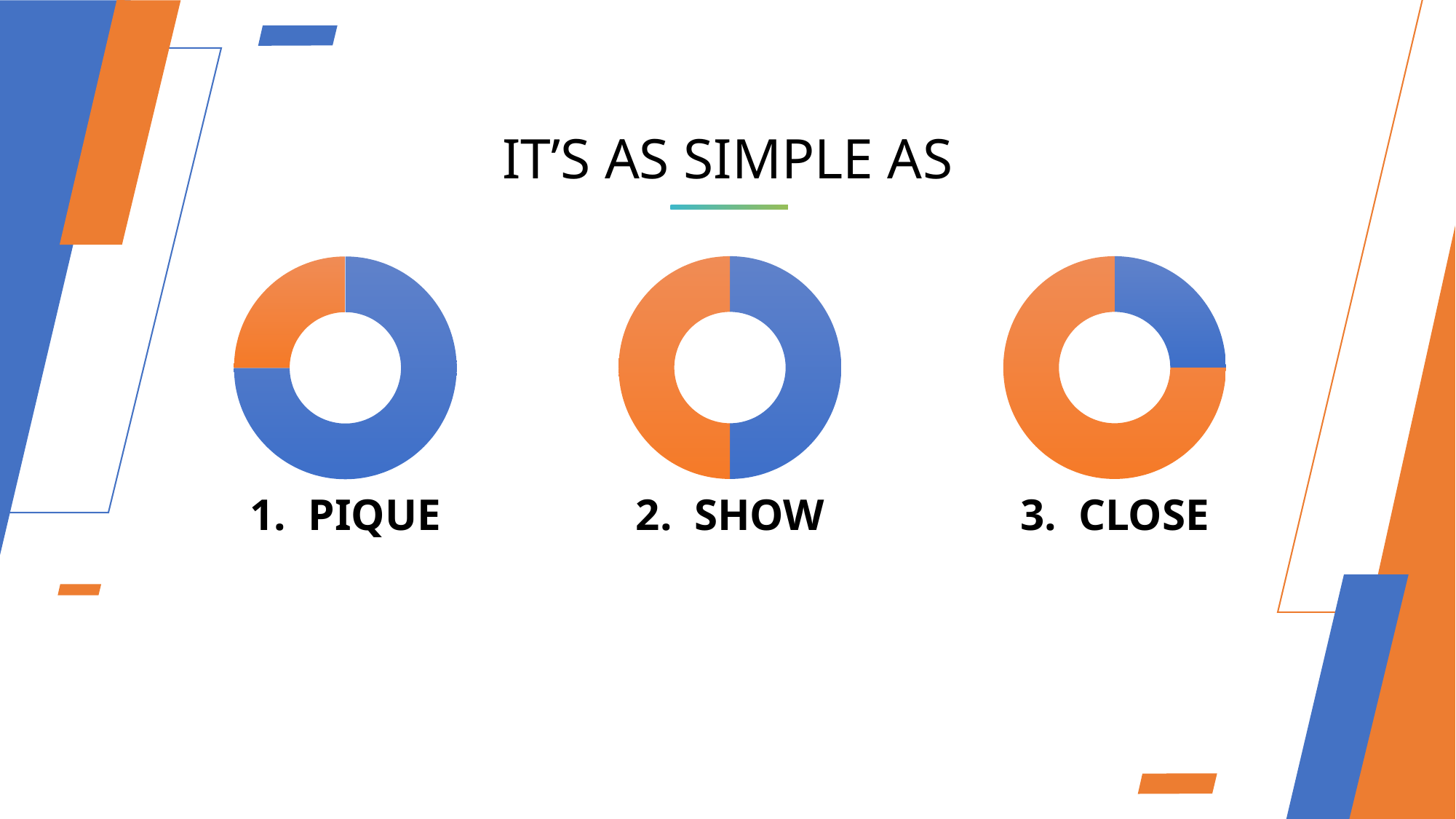
In the "3. CLOSE" chart, which slice is larger, the blue one or the orange one? orange Which of the three charts has the largest blue slice? 1. PIQUE In the "3. CLOSE" chart, how many slices are there? 2 In the "1. PIQUE" chart, how many slices are there? 2 Which of the three charts has the largest orange slice? 3. CLOSE What is the label under the middle chart? 2. SHOW What kind of chart is shown under the label "1. PIQUE"? doughnut chart How many charts are on the slide? 3 What is the title of the slide above the three charts? IT'S AS SIMPLE AS In the "1. PIQUE" chart, which slice is larger, the blue one or the orange one? blue